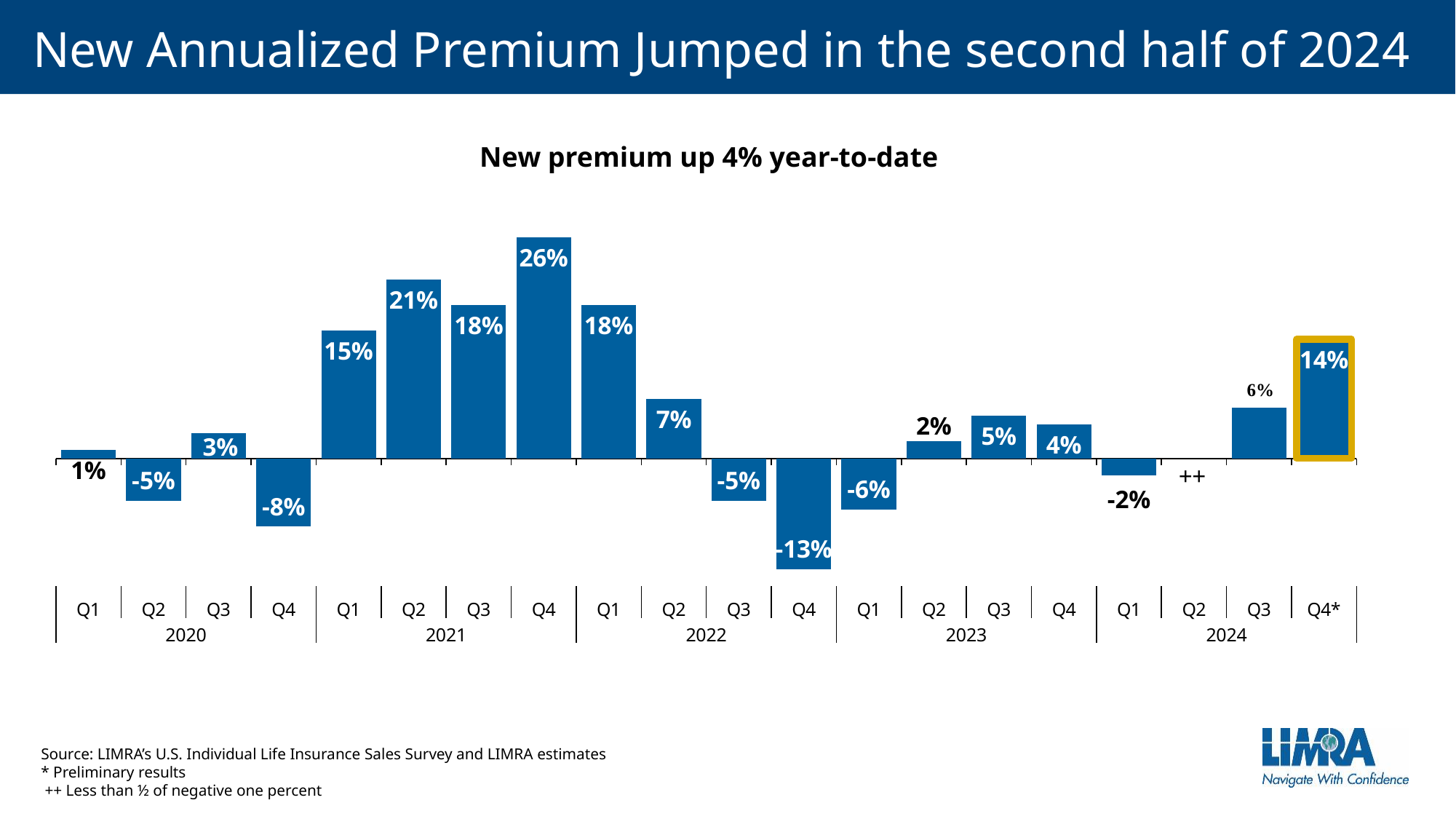
What is the value for Q3 2024? 6% What kind of chart is shown on the slide? Bar chart What is the value for Q4 2024? 14% Which quarter has the lowest value? Q4 2022 What is the value for Q4 2021? 26% Which quarter has the highest value? Q4 2021 What is the value for Q4 2022? -13% Do the values rise or fall from Q1 2021 to Q4 2021? Rise What is the difference between the values for Q4 2024 and Q3 2024? 8% What is the subtitle shown above the chart? New premium up 4% year-to-date Which is larger, the value for Q1 2021 or the value for Q1 2022? Q1 2022 How many quarters are plotted on the chart? 20